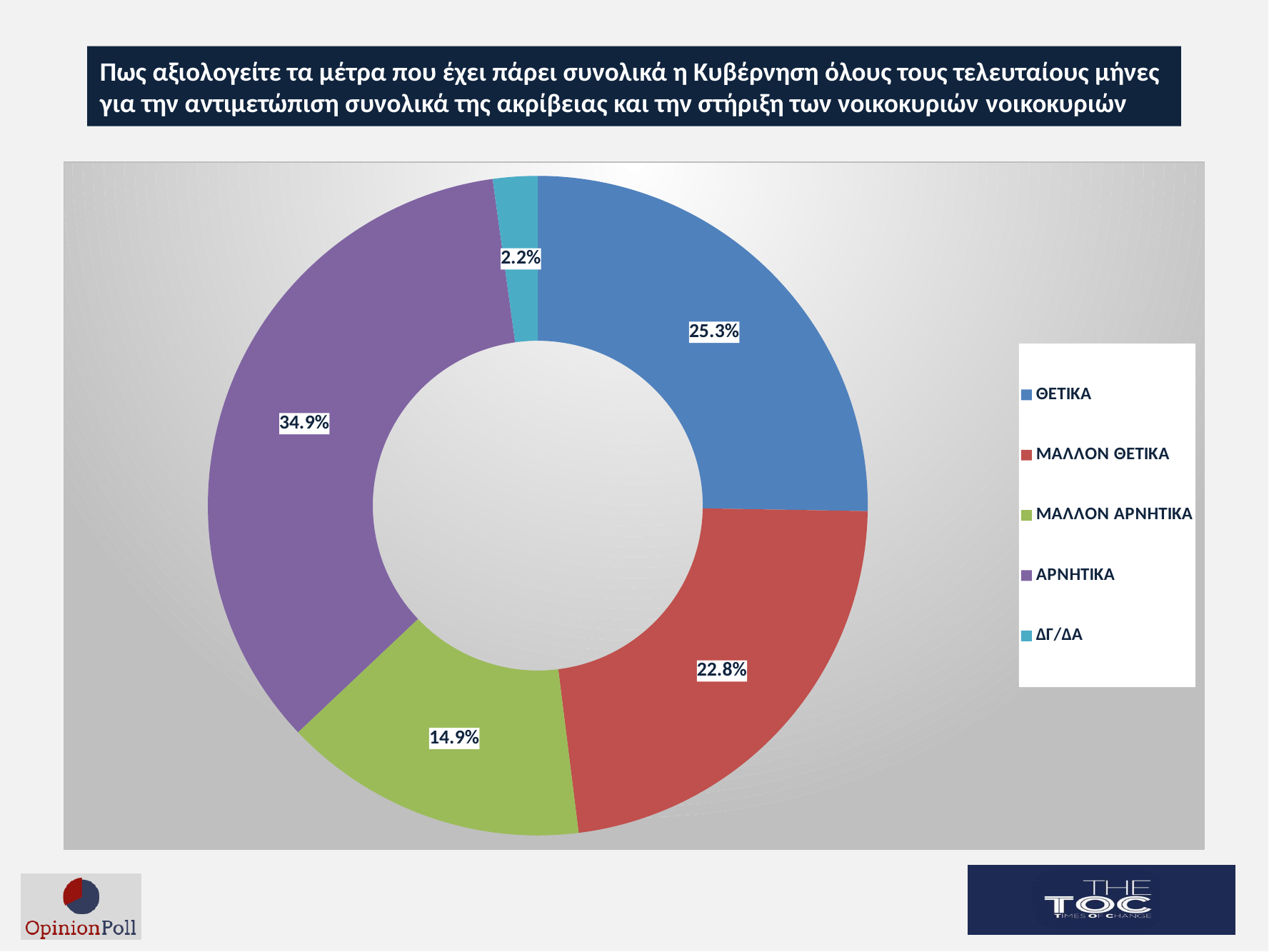
Which category has the smallest share of the chart? ΔΓ/ΔΑ What percentage is shown for ΑΡΝΗΤΙΚΑ? 34.9% What percentage is shown for ΜΑΛΛΟΝ ΑΡΝΗΤΙΚΑ? 14.9% How many categories are shown in the chart? 5 Which is larger, ΜΑΛΛΟΝ ΘΕΤΙΚΑ or ΜΑΛΛΟΝ ΑΡΝΗΤΙΚΑ? ΜΑΛΛΟΝ ΘΕΤΙΚΑ What percentage is shown for ΘΕΤΙΚΑ? 25.3% What percentage is shown for ΜΑΛΛΟΝ ΘΕΤΙΚΑ? 22.8% What colour represents ΑΡΝΗΤΙΚΑ in the chart? Purple What percentage is shown for ΔΓ/ΔΑ? 2.2% Which category has the largest share of the chart? ΑΡΝΗΤΙΚΑ What is the difference in percentage points between ΑΡΝΗΤΙΚΑ and ΘΕΤΙΚΑ? 9.6 What kind of chart is shown on the slide? Doughnut (pie) chart